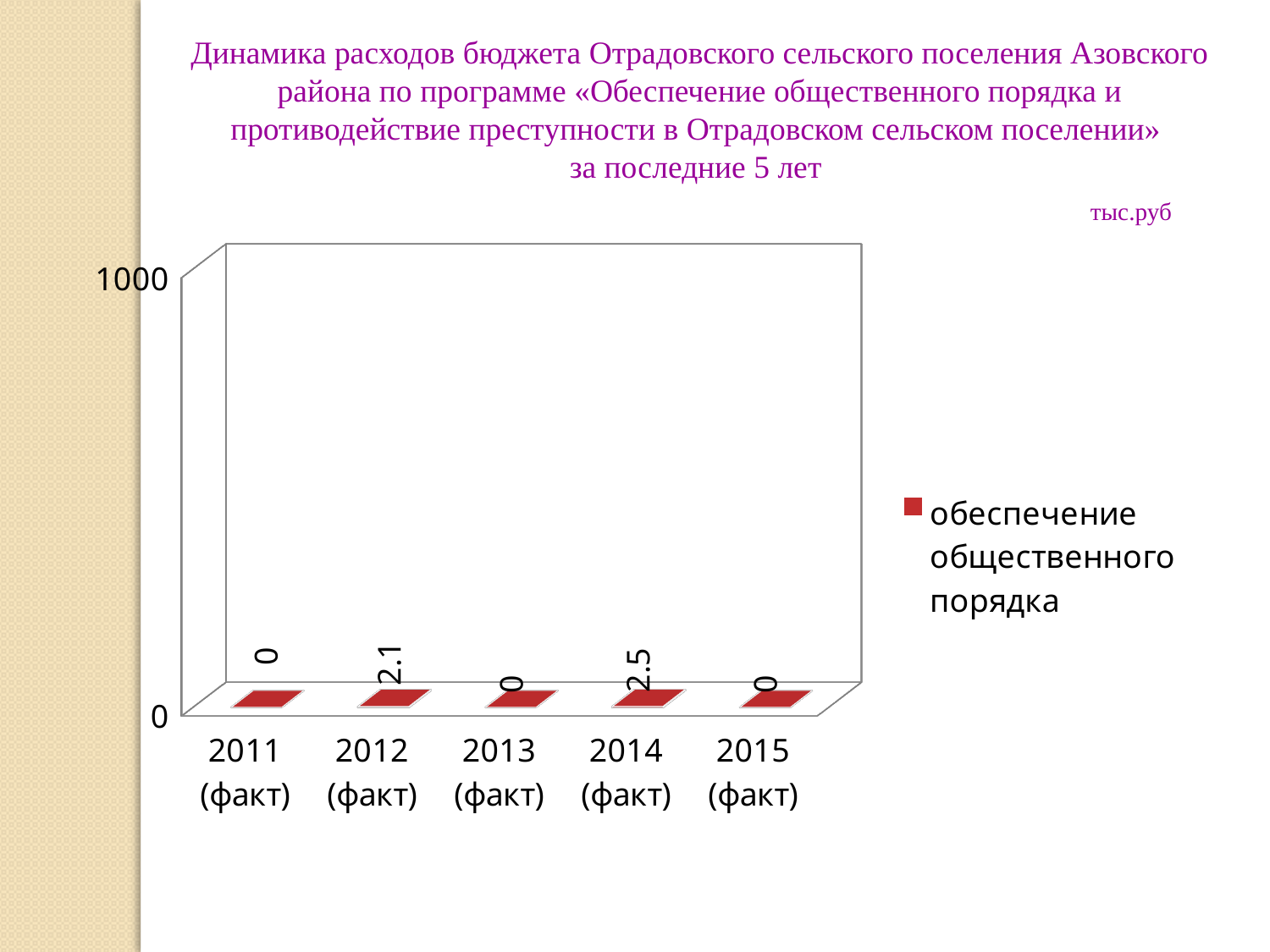
Is the value for 2014 (факт) greater or less than 1000? less How many categories are shown on the x axis? 5 What is the value for 2013 (факт)? 0 What is the value for 2014 (факт)? 2.5 How many series does the legend list? 1 Which year has the highest value? 2014 (факт) Which is larger, the value for 2012 (факт) or the value for 2014 (факт)? 2014 (факт) What is the name of the series in the legend? обеспечение общественного порядка What kind of chart is shown? bar chart What is the difference between the values for 2014 (факт) and 2012 (факт)? 0.4 What is the value for 2012 (факт)? 2.1 What is the value for 2011 (факт)? 0